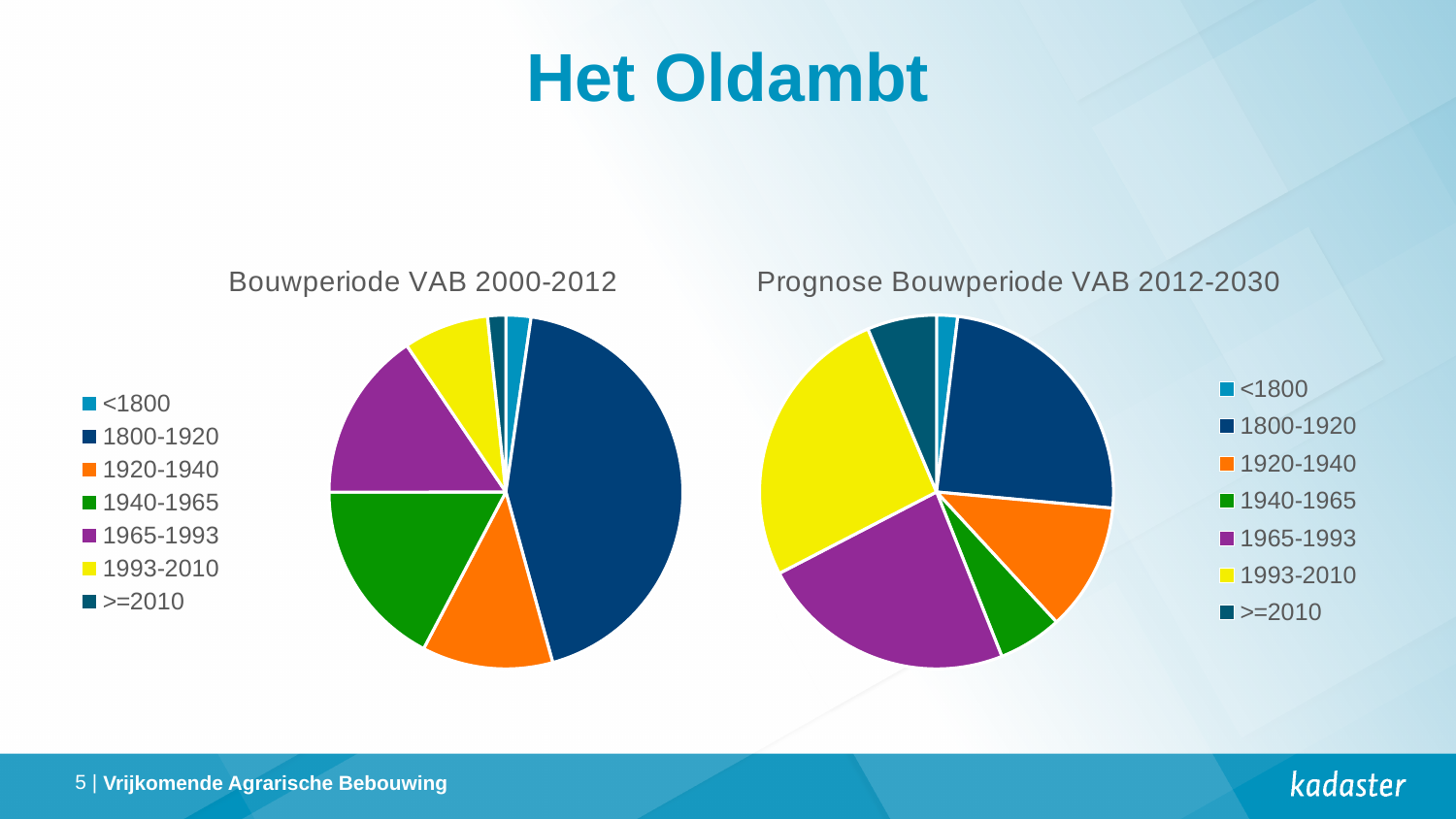
In the chart 'Prognose Bouwperiode VAB 2012-2030', how many entries does the legend list? 7 What is the title of the pie chart on the right side of the slide? Prognose Bouwperiode VAB 2012-2030 In the chart 'Bouwperiode VAB 2000-2012', which slice is larger: 1940-1965 or 1920-1940? 1940-1965 In the chart 'Bouwperiode VAB 2000-2012', how many slices does the pie have? 7 In the chart 'Bouwperiode VAB 2000-2012', which slice is larger: 1965-1993 or 1993-2010? 1965-1993 What kind of chart is the chart titled 'Bouwperiode VAB 2000-2012'? pie chart In the chart 'Prognose Bouwperiode VAB 2012-2030', which slice is larger: 1920-1940 or 1940-1965? 1920-1940 In the chart 'Bouwperiode VAB 2000-2012', which building period has the largest slice? 1800-1920 What kind of chart is the chart titled 'Prognose Bouwperiode VAB 2012-2030'? pie chart In the chart 'Prognose Bouwperiode VAB 2012-2030', which building period has the smallest slice? <1800 In the chart 'Prognose Bouwperiode VAB 2012-2030', which building period has the largest slice? 1993-2010 In the chart 'Bouwperiode VAB 2000-2012', what colour represents the 1993-2010 period? yellow